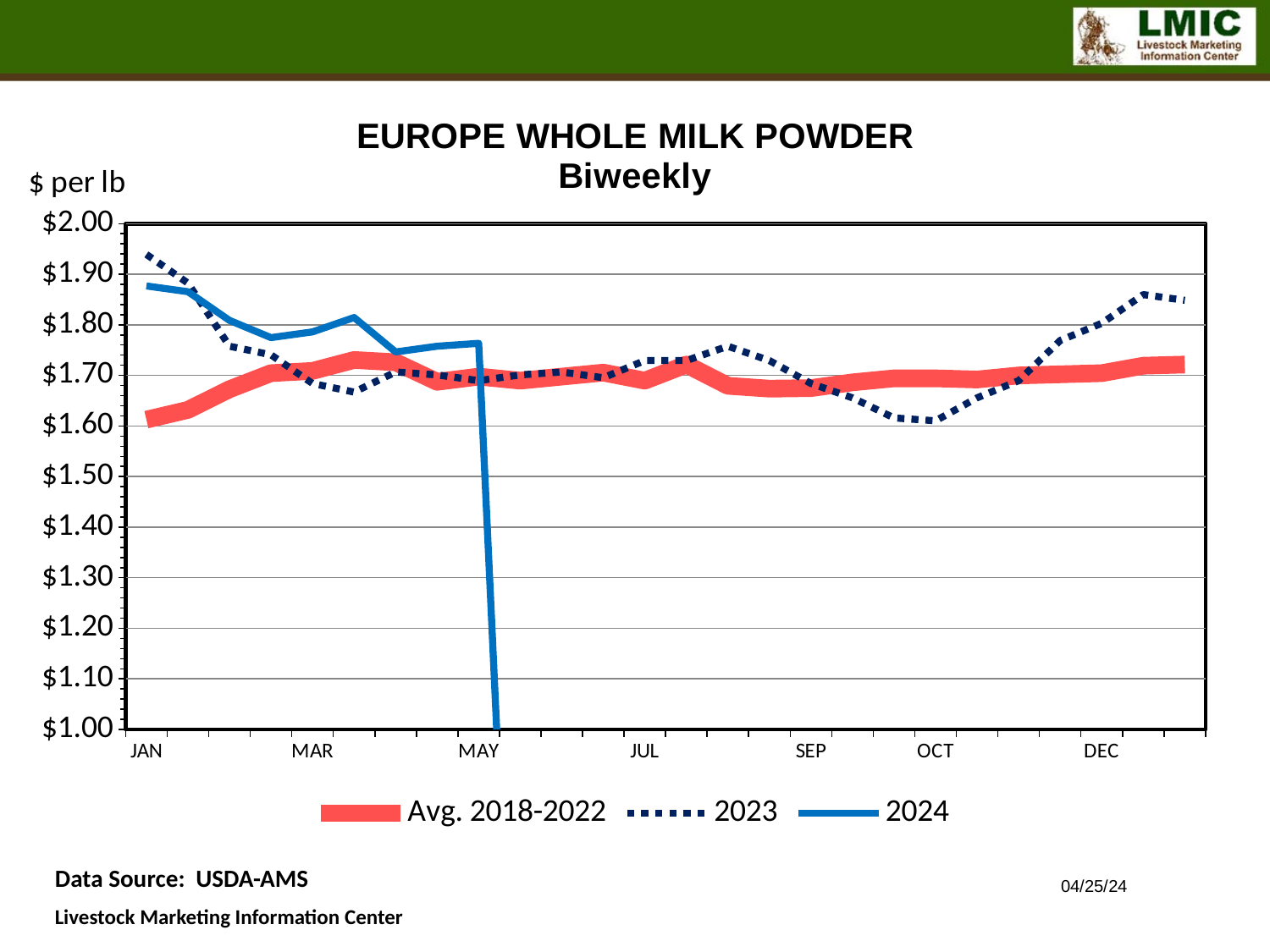
Does the 2024 line rise or fall from JAN to MAR? fall What unit is shown on the y axis of the chart? $ per lb What is the title of the chart? EUROPE WHOLE MILK POWDER Biweekly Which series has the lowest value in JAN? Avg. 2018-2022 How many series does the legend list? 3 Is the value for 2023 in OCT greater or less than $1.70? less Is the value for 2024 in JAN greater or less than $1.90? less Is the value for Avg. 2018-2022 in JAN greater or less than $1.70? less Which series has the highest value in JAN? 2023 What kind of chart is shown on the slide? line chart